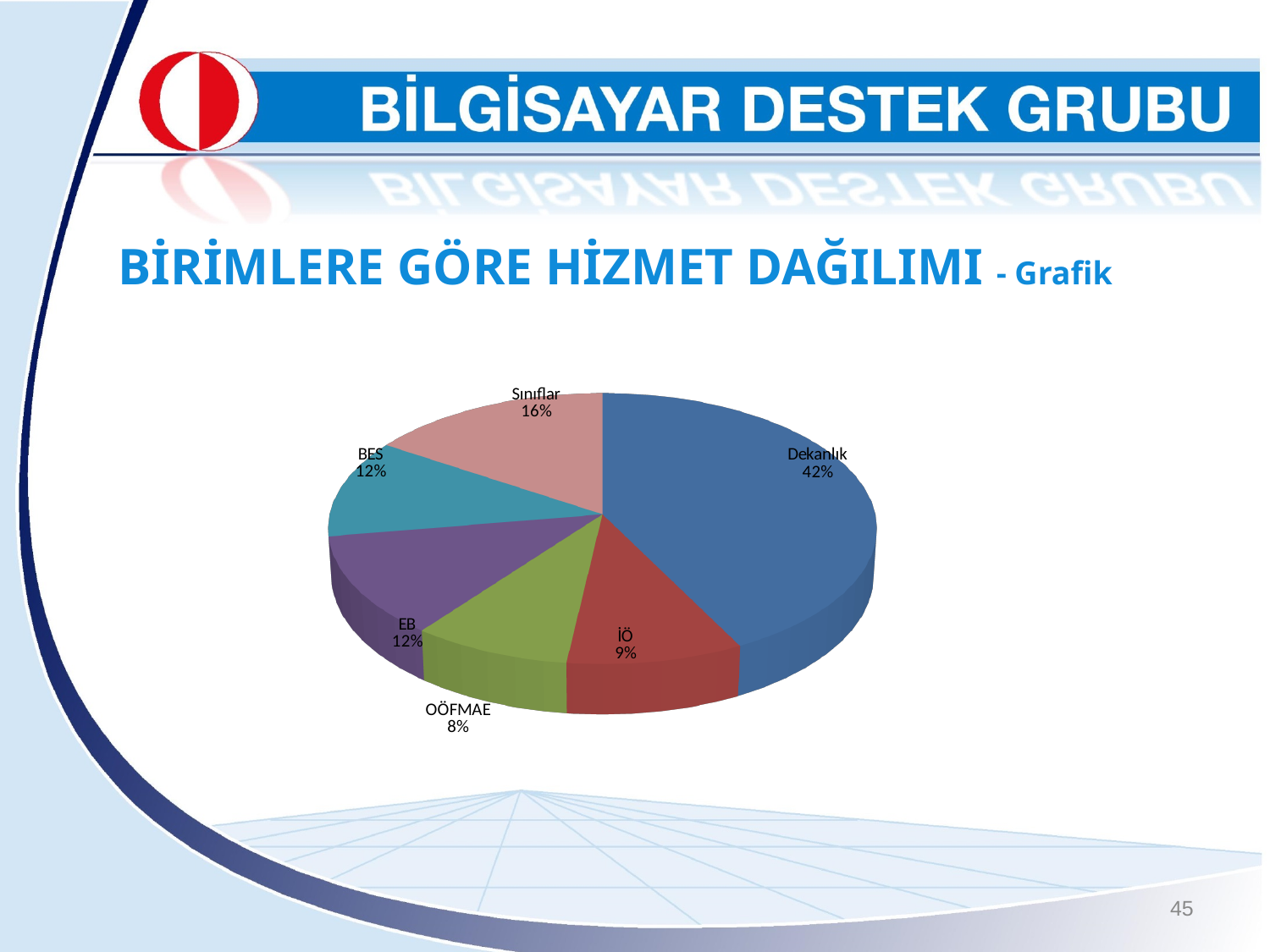
Which category has the largest slice of the pie? Dekanlık Which is larger, the share for Sınıflar or the share for BES? Sınıflar What share of the pie does İÖ have? 9% What kind of chart is shown on the slide? pie chart What colour is the Dekanlık slice? blue How many slices does the pie chart have? 6 What is the difference in percentage points between Dekanlık and Sınıflar? 26 Which category has the smallest slice of the pie? OÖFMAE What share of the pie does OÖFMAE have? 8% What share of the pie does Sınıflar have? 16% What is the difference in percentage points between İÖ and OÖFMAE? 1